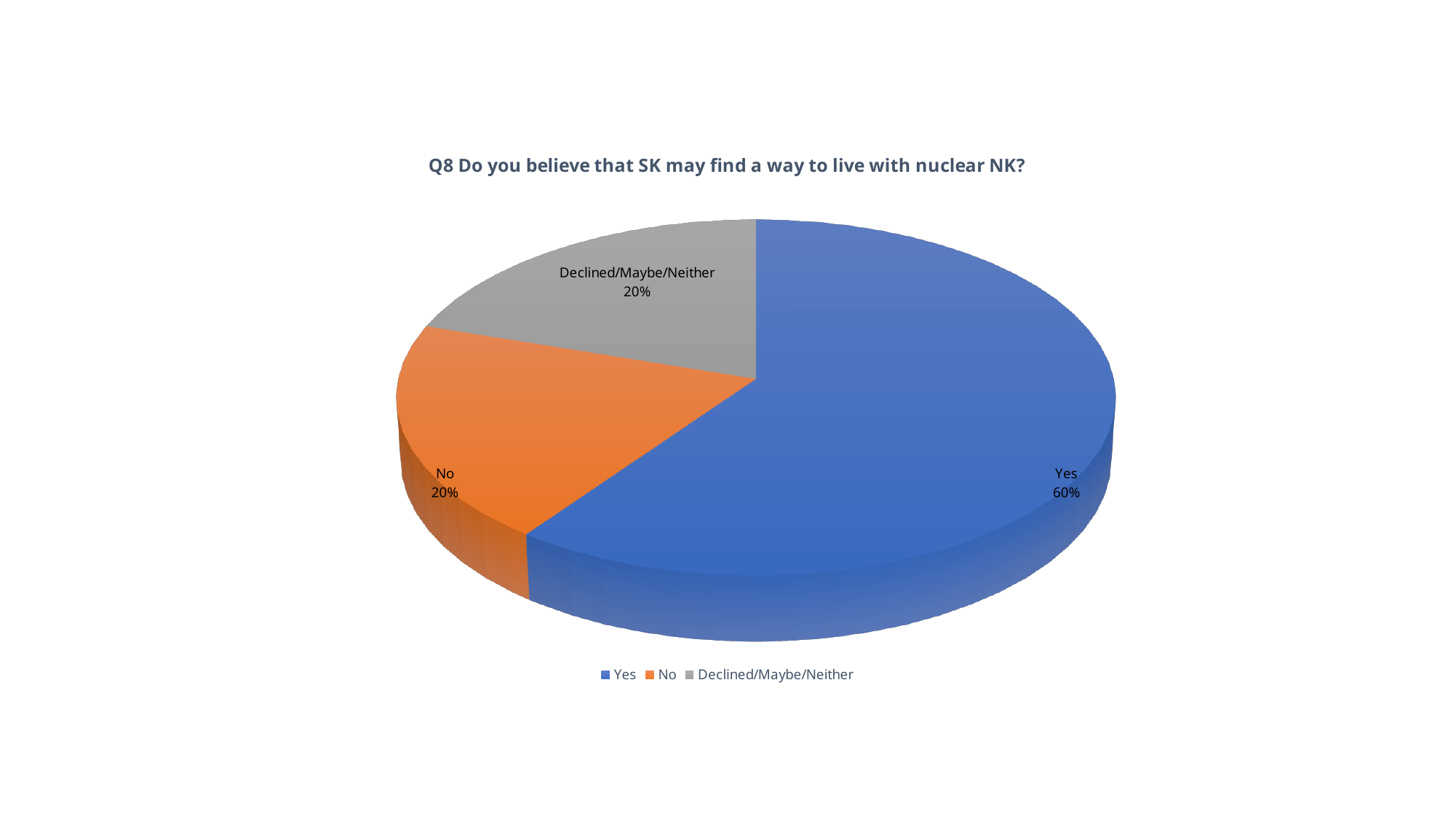
How many slices does the pie chart have? 3 Which category has the largest share of the pie? Yes What is the difference in percentage points between the Yes slice and the No slice? 40 What is the title of the chart? Q8 Do you believe that SK may find a way to live with nuclear NK? What colour is the Yes slice? Blue Which is larger, the Yes slice or the Declined/Maybe/Neither slice? Yes What is the combined share of the No and Declined/Maybe/Neither slices? 40% What is the value shown for the Declined/Maybe/Neither slice? 20% What kind of chart is shown on the slide? Pie chart How many entries does the legend list? 3 What is the value shown for the No slice? 20% What share of the pie does the Yes slice represent? 60%